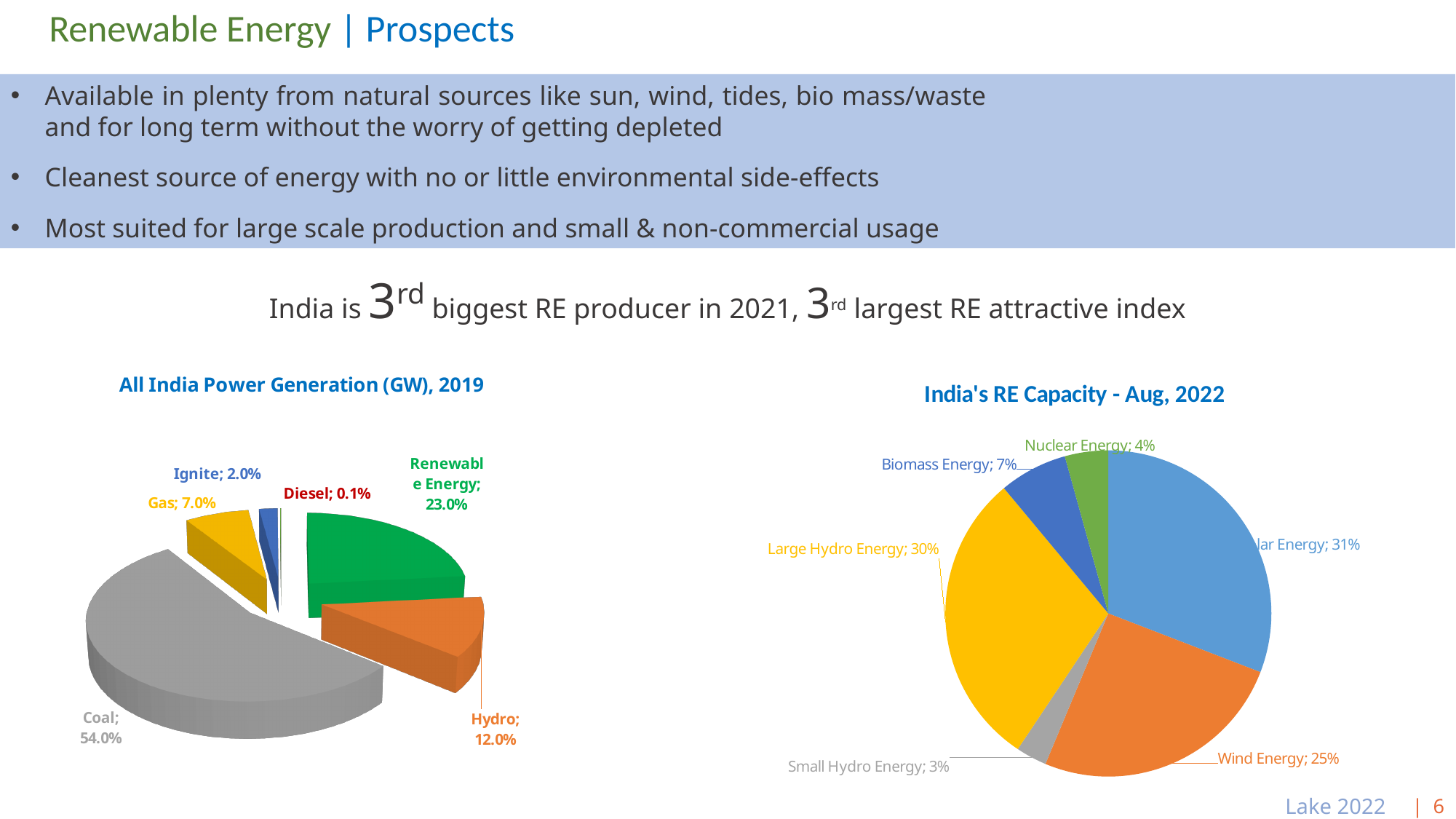
In the 'All India Power Generation (GW), 2019' chart, what share does Coal have? 54.0% How many categories are shown in the 'All India Power Generation (GW), 2019' chart? 6 In the 'All India Power Generation (GW), 2019' chart, which category has the largest share? Coal In the 'All India Power Generation (GW), 2019' chart, which category has the smallest share? Diesel In the 'India's RE Capacity - Aug, 2022' chart, which is larger, Large Hydro Energy or Wind Energy? Large Hydro Energy In the 'India's RE Capacity - Aug, 2022' chart, what is the difference between Wind Energy and Biomass Energy? 18% In the 'India's RE Capacity - Aug, 2022' chart, what is the value for Nuclear Energy? 4% What kind of chart is 'India's RE Capacity - Aug, 2022'? Pie chart In the 'India's RE Capacity - Aug, 2022' chart, which category has the smallest share? Small Hydro Energy In the 'All India Power Generation (GW), 2019' chart, what is the difference between Renewable Energy and Hydro? 11.0% In the 'All India Power Generation (GW), 2019' chart, which is larger, Gas or Ignite? Gas In the 'All India Power Generation (GW), 2019' chart, what is the value for Renewable Energy? 23.0%